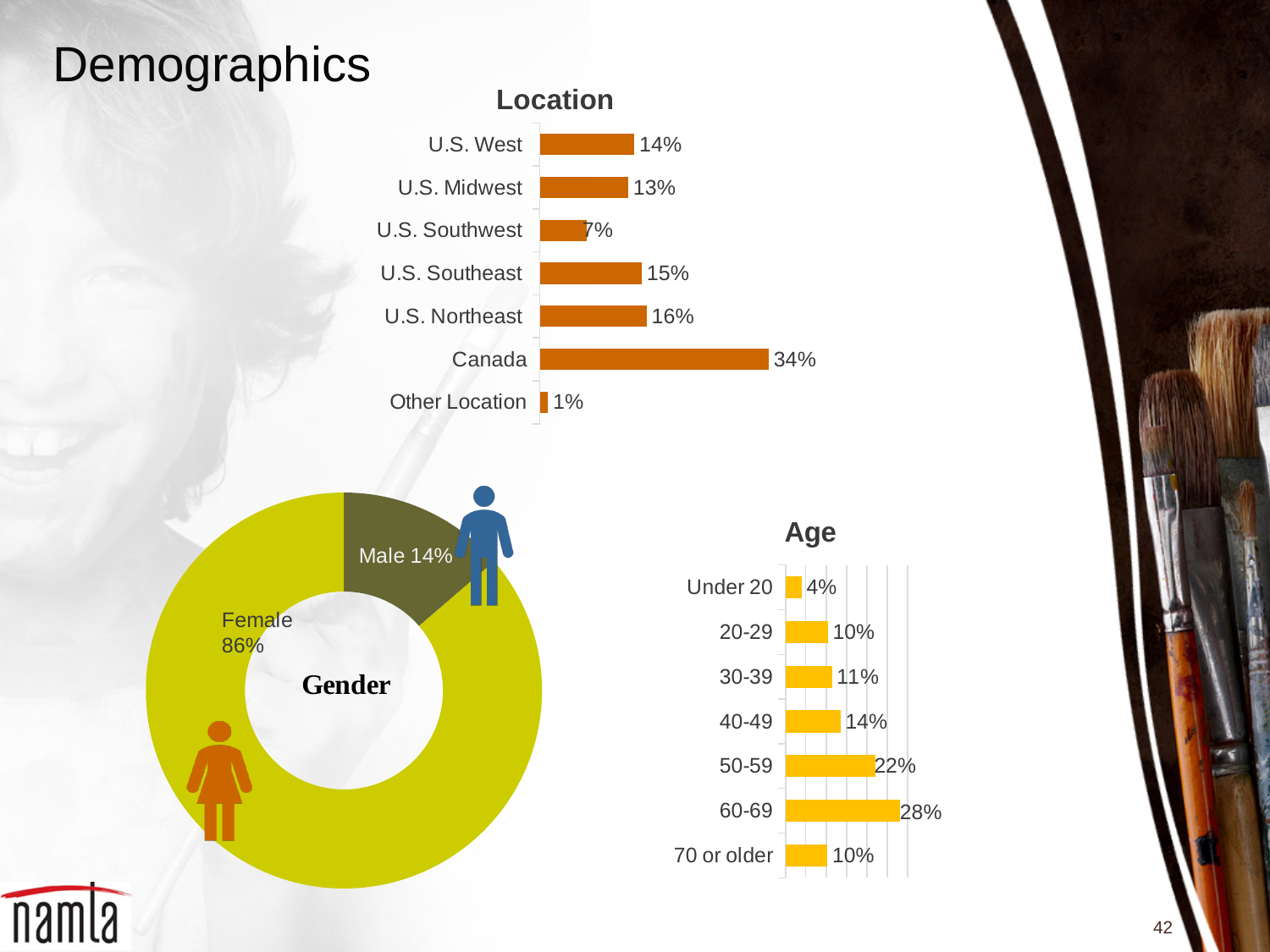
What kind of chart is the Age chart? Bar chart In the Location chart, which location has the lowest percentage? Other Location In the Gender chart, what share is Female? 86% In the Age chart, how many age groups are shown? 7 In the Location chart, what is the difference between U.S. Northeast and U.S. Southwest? 9% In the Location chart, which is larger, U.S. West or U.S. Midwest? U.S. West In the Age chart, what is the difference between the 60-69 and Under 20 groups? 24% In the Age chart, which age group has the highest percentage? 60-69 In the Location chart, what percentage is shown for Canada? 34% In the Age chart, what percentage is shown for 50-59? 22% What kind of chart is the Gender chart? Doughnut chart In the Location chart, how many locations are listed? 7